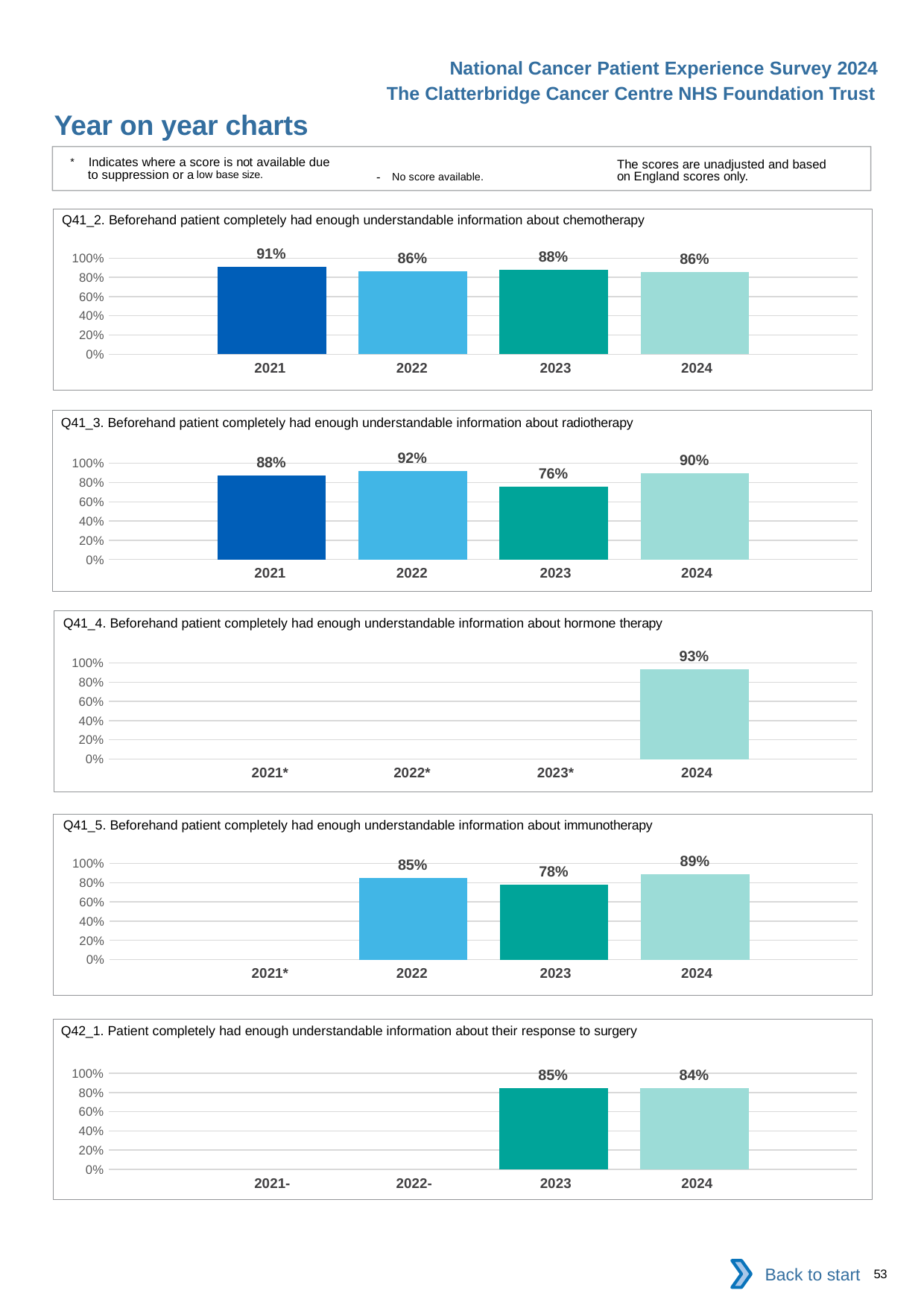
In the Q41_3 chart (radiotherapy), what is the value for 2023? 76% In the Q41_5 chart (immunotherapy), which is larger, the value for 2022 or the value for 2023? 2022 In the Q42_1 chart (response to surgery), what is the value for 2024? 84% In the Q41_4 chart (hormone therapy), how many years have a bar plotted? 1 In the Q41_2 chart (chemotherapy), what is the value for 2021? 91% In the Q41_3 chart (radiotherapy), which year has the lowest value? 2023 In the Q41_4 chart (hormone therapy), what is the value for 2024? 93% In the Q41_5 chart (immunotherapy), what is the difference between the 2024 and 2023 values? 11% In the Q42_1 chart (response to surgery), is the value for 2023 greater or less than 80%? greater In the Q41_2 chart (chemotherapy), which year has the highest value? 2021 In the Q41_3 chart (radiotherapy), what is the difference between the 2022 and 2023 values? 16% What kind of chart is the Q41_2 chart (chemotherapy)? Bar chart